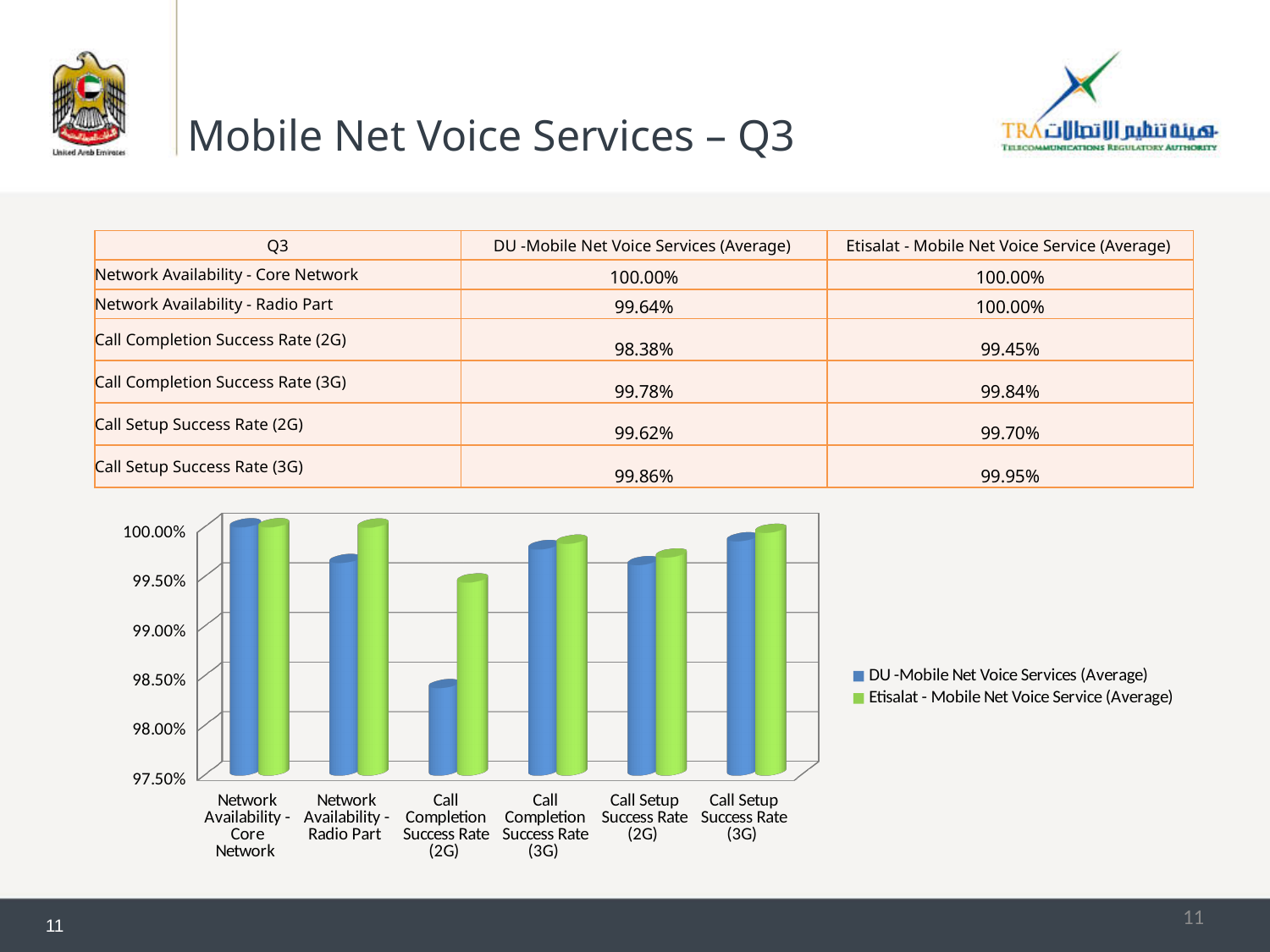
What is the Etisalat - Mobile Net Voice Service (Average) value for Call Setup Success Rate (3G)? 99.95% What is the difference between the Etisalat and DU values for Call Completion Success Rate (2G)? 1.07% What is the DU - Mobile Net Voice Services (Average) value for Call Completion Success Rate (2G)? 98.38% How many series does the chart legend list? 2 Which category has the lowest value for DU - Mobile Net Voice Services (Average)? Call Completion Success Rate (2G) Is the DU value for Call Completion Success Rate (2G) greater or less than 98.50%? less For Network Availability - Radio Part, which series has the larger value, DU or Etisalat? Etisalat How many categories are shown on the x axis of the chart? 6 What kind of chart is shown on the slide? bar chart What is the lowest value shown on the chart's vertical axis? 97.50% Which colour represents Etisalat - Mobile Net Voice Service (Average) in the chart? green Is the Etisalat value for Call Completion Success Rate (2G) greater or less than 99.00%? greater